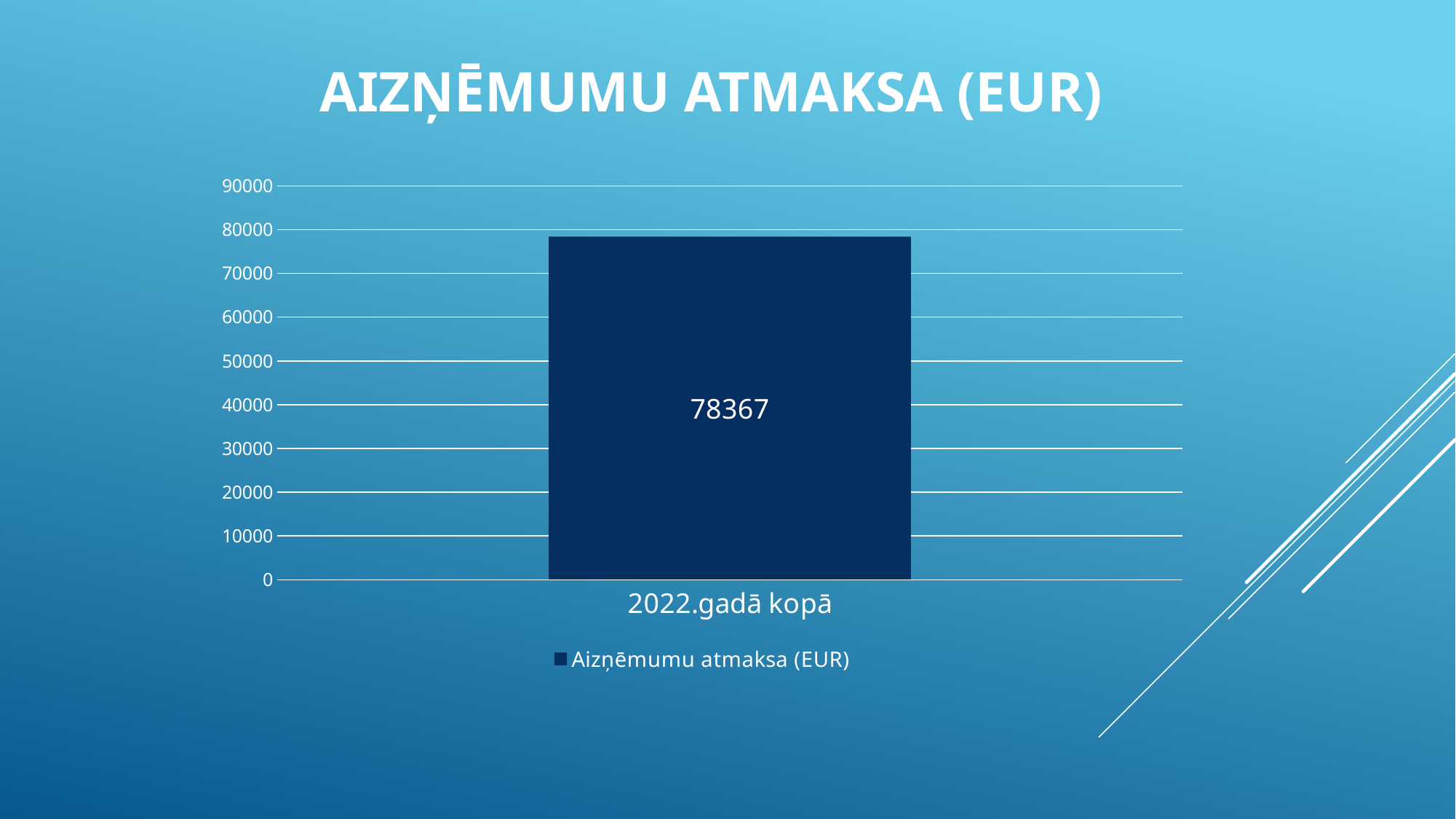
What is the category label on the x axis? 2022.gadā kopā What is the value for 2022.gadā kopā? 78367 What is the title of the chart? AIZŅĒMUMU ATMAKSA (EUR) Is the value for 2022.gadā kopā greater or less than 80000? less What kind of chart is shown on the slide? bar chart How many bars does the chart show? 1 What is the highest value shown on the vertical axis? 90000 Is the value for 2022.gadā kopā greater or less than 70000? greater What is the legend entry shown below the chart? Aizņēmumu atmaksa (EUR) How many series does the legend list? 1